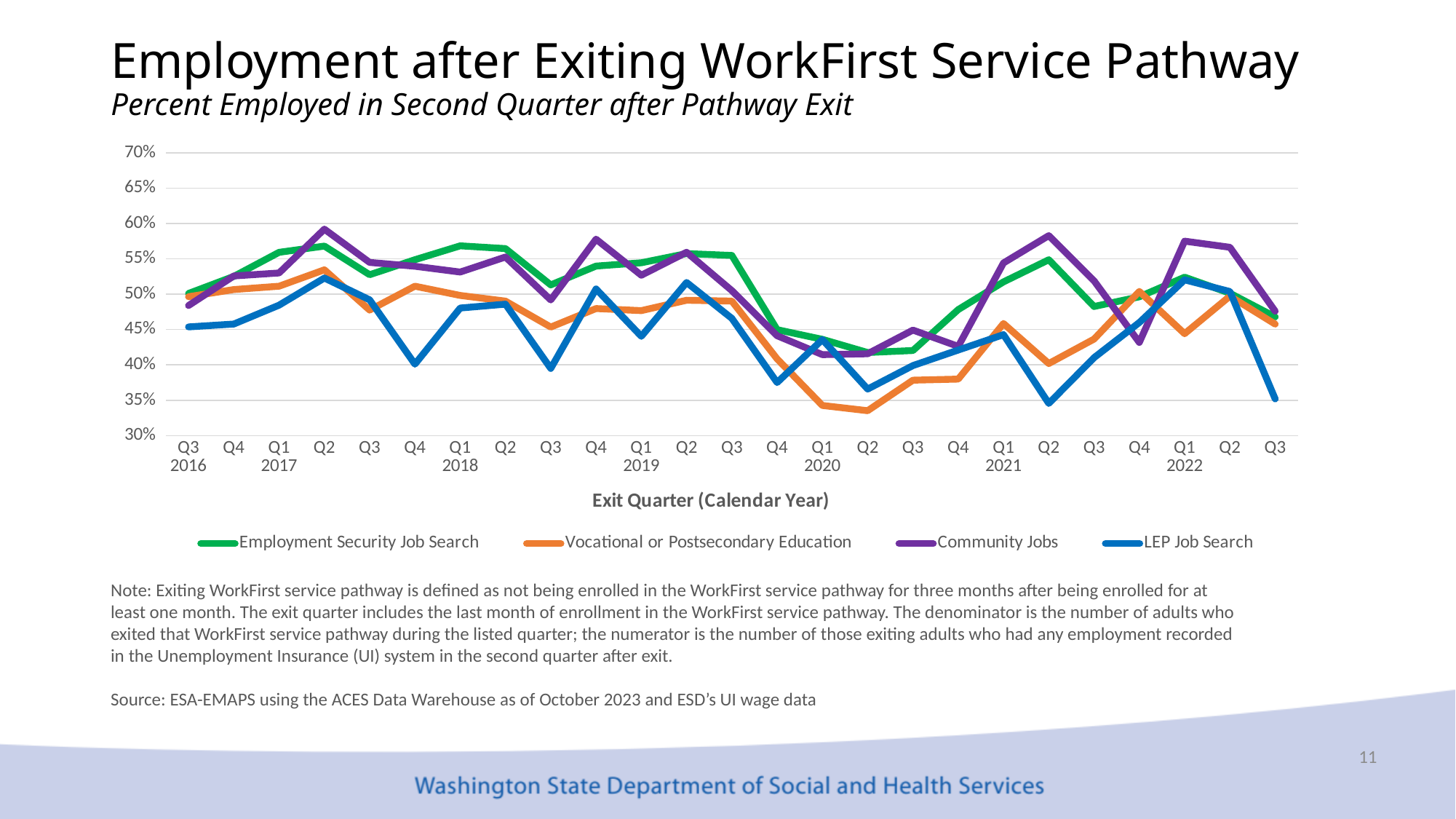
What is the title of the x axis? Exit Quarter (Calendar Year) Is the value for Vocational or Postsecondary Education in Q2 2020 greater or less than 35%? less Which series has the lowest value in Q3 2022? LEP Job Search How many exit quarters are plotted along the x axis? 25 Is the value for Employment Security Job Search in Q2 2021 greater or less than 50%? greater Does the LEP Job Search line rise or fall from Q2 2022 to Q3 2022? Fall Which series has the highest value in Q2 2017? Community Jobs What kind of chart is shown on the slide? Line chart Is the value for Community Jobs in Q2 2017 greater or less than 55%? greater In Q2 2020, which is larger: Community Jobs or Vocational or Postsecondary Education? Community Jobs How many series does the legend list? 4